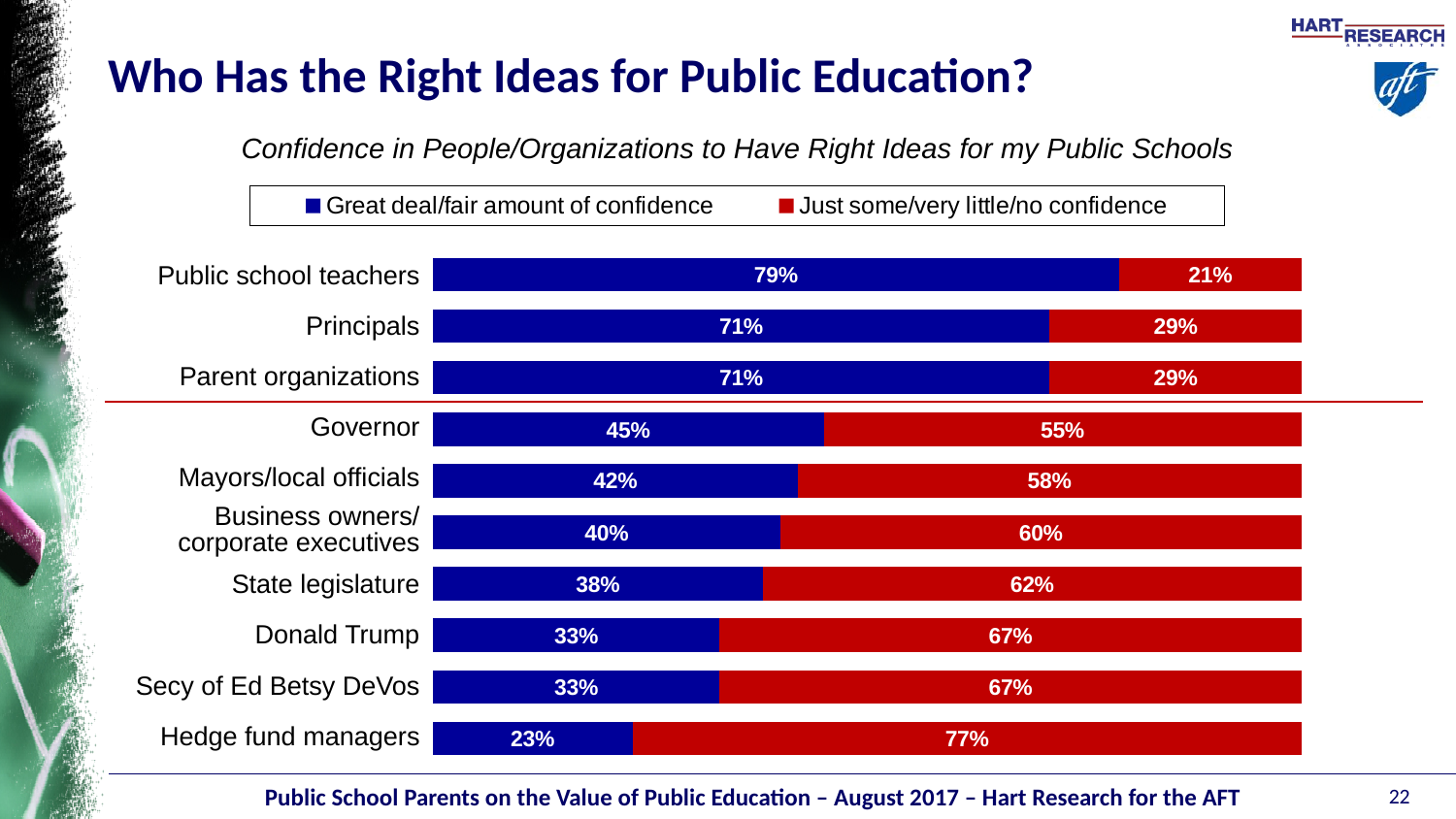
Which category has the highest great deal/fair amount of confidence value? Public school teachers How many categories are shown in the chart? 10 What is the total of the two segments for the Secy of Ed Betsy DeVos bar? 100% What percentage of respondents have a great deal/fair amount of confidence in public school teachers? 79% What percentage of respondents have just some/very little/no confidence in hedge fund managers? 77% What is the great deal/fair amount of confidence value for the Governor? 45% Which has a higher great deal/fair amount of confidence value, Mayors/local officials or State legislature? Mayors/local officials Which colour represents just some/very little/no confidence in the chart? Red What kind of chart is shown on the slide? Stacked bar chart What is the difference between the great deal/fair amount of confidence values for Principals and Donald Trump? 38 percentage points Which category has the lowest great deal/fair amount of confidence value? Hedge fund managers How many series does the legend list? 2